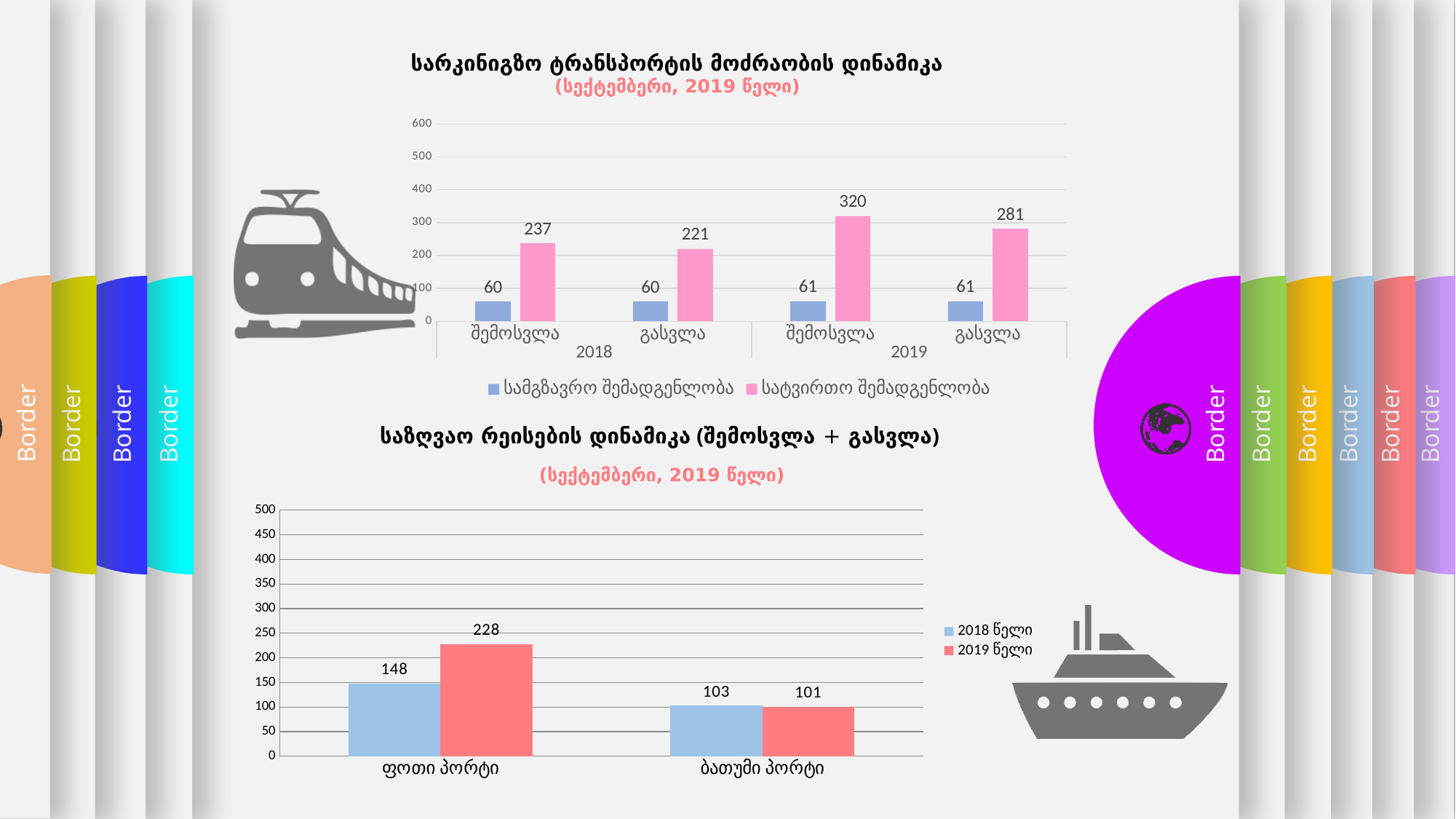
In the bottom chart (sea voyages), how many port categories are shown on the x axis? 2 In the top chart (railway transport), what is the difference between the სატვირთო შემადგენლობა values for შემოსვლა in 2019 and შემოსვლა in 2018? 83 In the top chart (railway transport), is the სატვირთო შემადგენლობა value for გასვლა in 2019 greater or less than 300? less In the top chart (railway transport), what is the value of სამგზავრო შემადგენლობა for გასვლა in 2018? 60 In the top chart (railway transport), what is the value of სატვირთო შემადგენლობა for შემოსვლა in 2019? 320 In the top chart (railway transport), which category has the highest სატვირთო შემადგენლობა value? შემოსვლა 2019 What type of chart is the bottom chart (sea voyages)? bar chart In the bottom chart (sea voyages), what is the value for ბათუმი პორტი in 2018 წელი? 103 In the bottom chart (sea voyages), what is the difference between the 2019 წელი and 2018 წელი values for ფოთი პორტი? 80 In the bottom chart (sea voyages), what is the value for ფოთი პორტი in 2019 წელი? 228 In the bottom chart (sea voyages), which port has the larger 2019 წელი value, ფოთი პორტი or ბათუმი პორტი? ფოთი პორტი In the top chart (railway transport), how many series does the legend list? 2